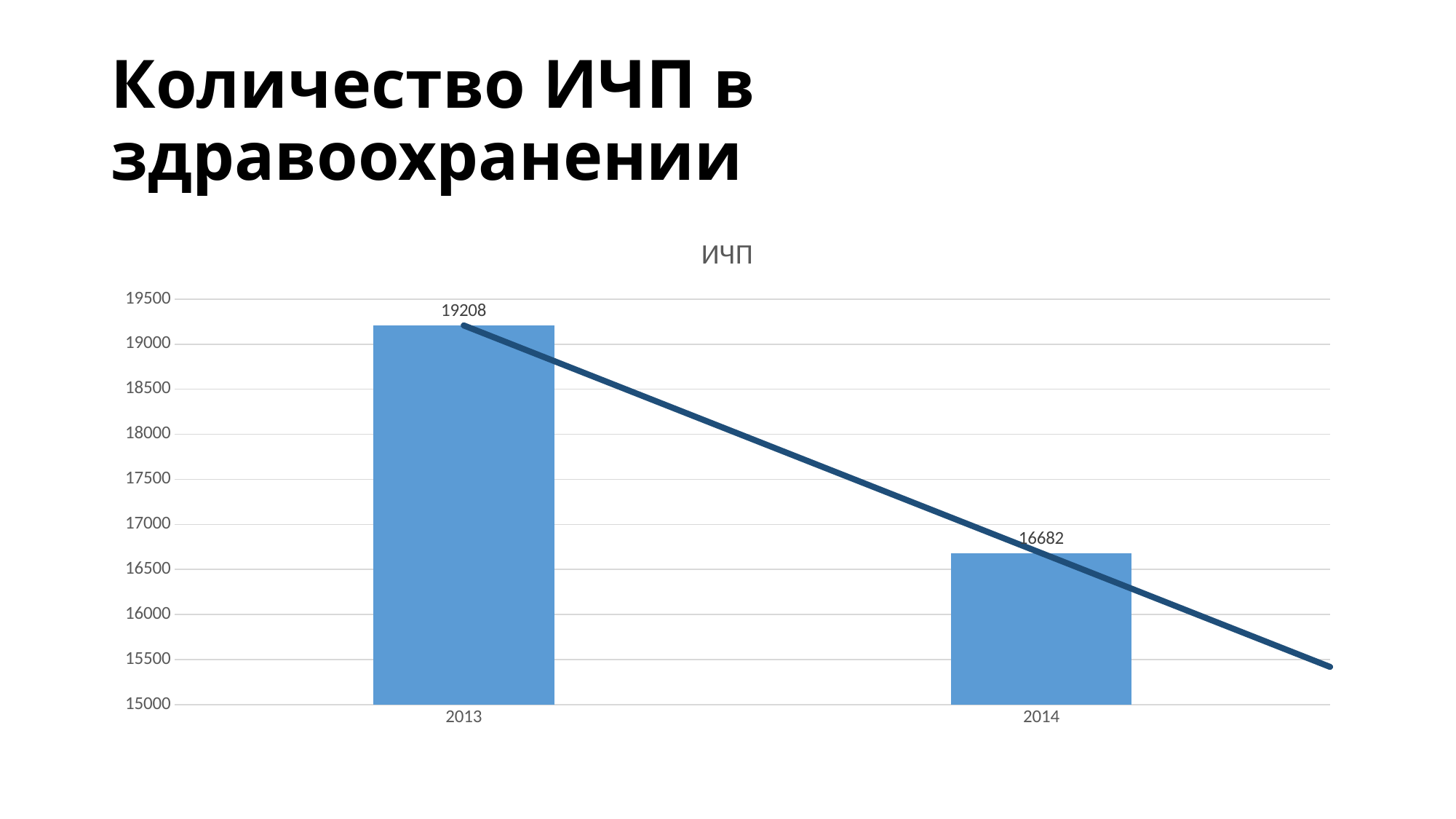
What is the difference between the values for 2013 and 2014? 2526 Do the values rise or fall from 2013 to 2014? fall Which year has the highest value? 2013 Is the value for 2014 greater or less than 17000? less What is the title of the chart? ИЧП Is the value for 2013 greater or less than 19000? greater What is the value for 2014? 16682 What is the value for 2013? 19208 What kind of chart is shown on the slide? bar chart Which year has the lowest value? 2014 How many bars are shown in the chart? 2 Which is larger, the value for 2013 or the value for 2014? 2013